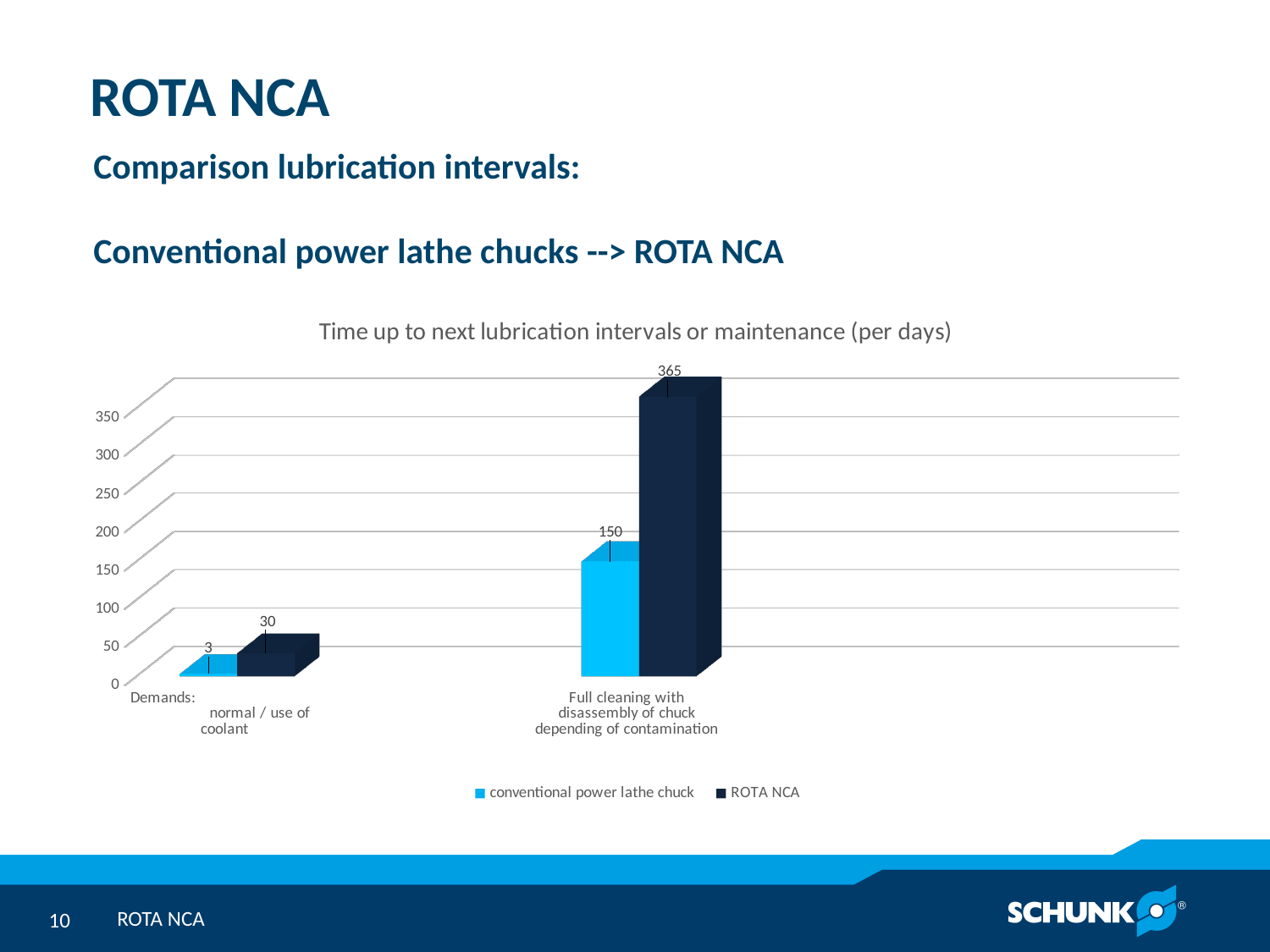
How many series does the legend list? 2 What is the value for the conventional power lathe chuck in the 'Full cleaning with disassembly of chuck depending of contamination' category? 150 What is the difference between the ROTA NCA and conventional power lathe chuck values in the 'Demands: normal / use of coolant' category? 27 In the 'Full cleaning with disassembly of chuck depending of contamination' category, which is larger: the conventional power lathe chuck value or the ROTA NCA value? ROTA NCA Which series has the highest value in the chart? ROTA NCA What is the value for ROTA NCA in the 'Demands: normal / use of coolant' category? 30 What is the title of the chart? Time up to next lubrication intervals or maintenance (per days) Which bar has the lowest value in the chart? conventional power lathe chuck, Demands: normal / use of coolant What is the value for the conventional power lathe chuck in the 'Demands: normal / use of coolant' category? 3 What is the difference between the ROTA NCA and conventional power lathe chuck values in the 'Full cleaning with disassembly of chuck depending of contamination' category? 215 What is the value for ROTA NCA in the 'Full cleaning with disassembly of chuck depending of contamination' category? 365 How many categories are shown on the x axis of the chart? 2